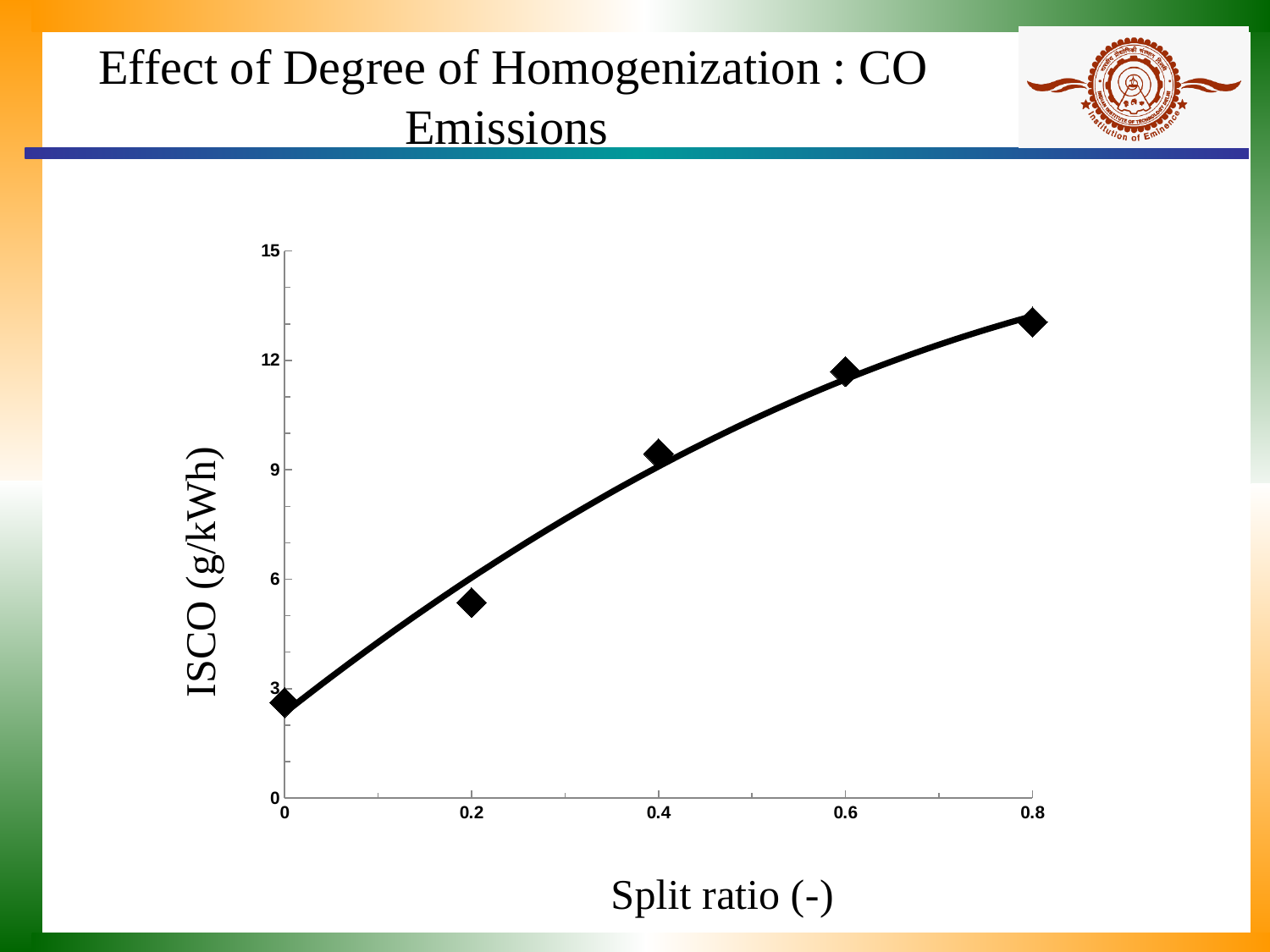
What is the label of the y axis? ISCO (g/kWh) Is the ISCO value at split ratio 0.8 greater or less than 12? greater What is the label of the x axis? Split ratio (-) What kind of chart is shown on the slide? scatter plot with a trend line At which split ratio is ISCO highest? 0.8 Does ISCO rise or fall as the split ratio increases? rise Which has the larger ISCO value, split ratio 0.2 or split ratio 0.6? 0.6 At which split ratio is ISCO lowest? 0 Is the ISCO value at split ratio 0.4 greater or less than 9? greater How many data points are plotted on the chart? 5 Is the ISCO value at split ratio 0 greater or less than 3? less